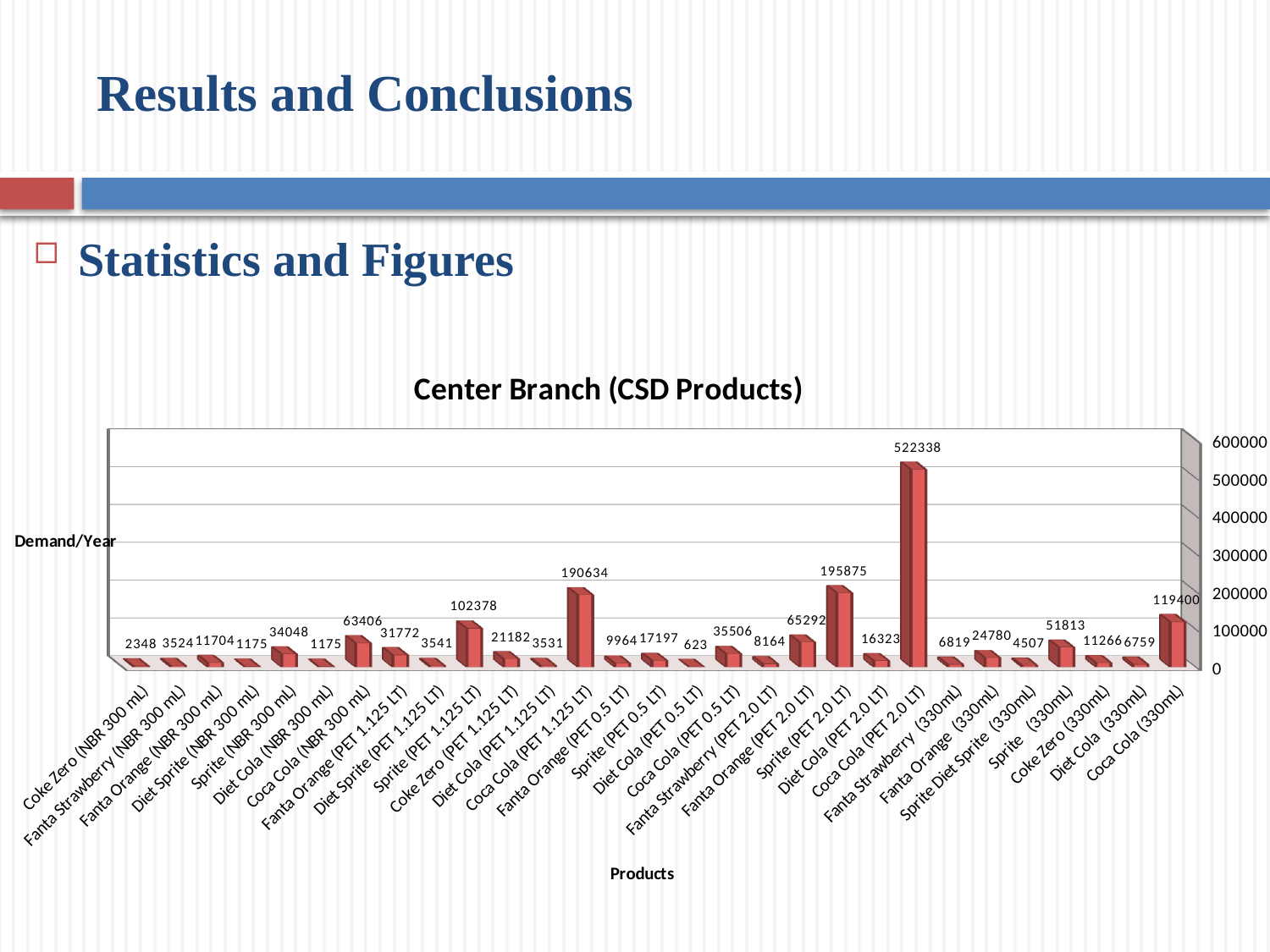
What is the difference in Demand/Year between Coca Cola (330mL) and Sprite (330mL)? 67587 Which product has the highest Demand/Year in the chart? Coca Cola (PET 2.0 LT) What is the Demand/Year value for Coca Cola (PET 2.0 LT) in the Center Branch (CSD Products) chart? 522338 Which has a larger Demand/Year: Sprite (PET 2.0 LT) or Coca Cola (PET 1.125 LT)? Sprite (PET 2.0 LT) What is the title of the chart on the slide? Center Branch (CSD Products) How many products are shown on the x axis of the chart? 29 Is the Demand/Year value for Coca Cola (PET 2.0 LT) greater or less than 500000? greater What is the Demand/Year value for Sprite (PET 1.125 LT)? 102378 What kind of chart is shown on the slide? Bar chart Which product has the lowest Demand/Year in the chart? Diet Cola (PET 0.5 LT) What is the difference in Demand/Year between Coca Cola (PET 2.0 LT) and Sprite (PET 2.0 LT)? 326463 What is the Demand/Year value for Fanta Orange (330mL)? 24780